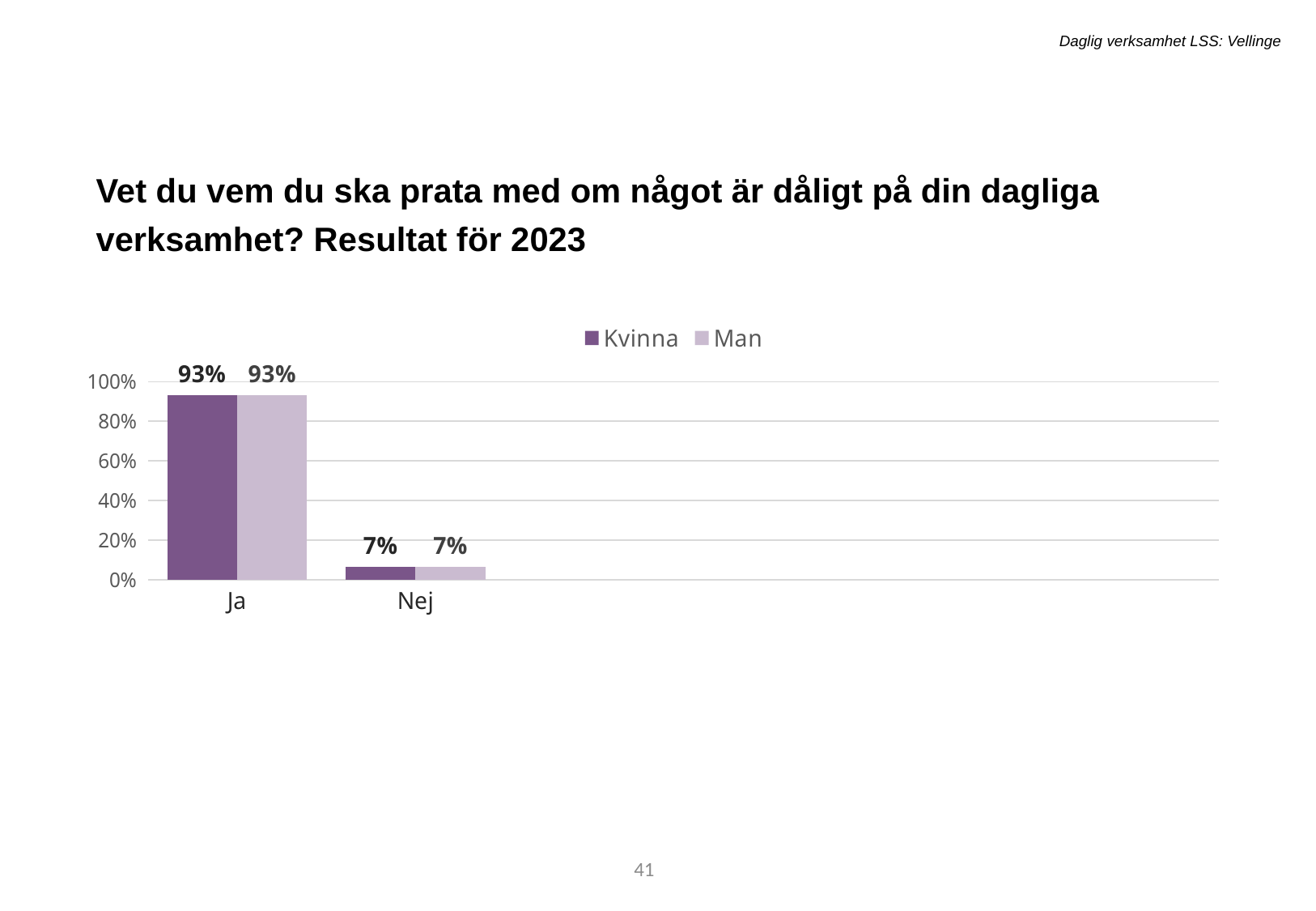
How many series does the legend list? 2 Is the value for Kvinna in the Ja category greater or less than 80%? greater What kind of chart is shown on the slide? bar chart What is the value for Man in the Ja category? 93% How many categories are shown on the x axis? 2 Which category has the lowest value for Man? Nej What is the value for Kvinna in the Ja category? 93% What is the value for Kvinna in the Nej category? 7% What is the difference between the Kvinna values for Ja and Nej? 86% What is the value for Man in the Nej category? 7% Which category has the highest value for Kvinna? Ja Which is larger for Man: the value for Ja or the value for Nej? Ja